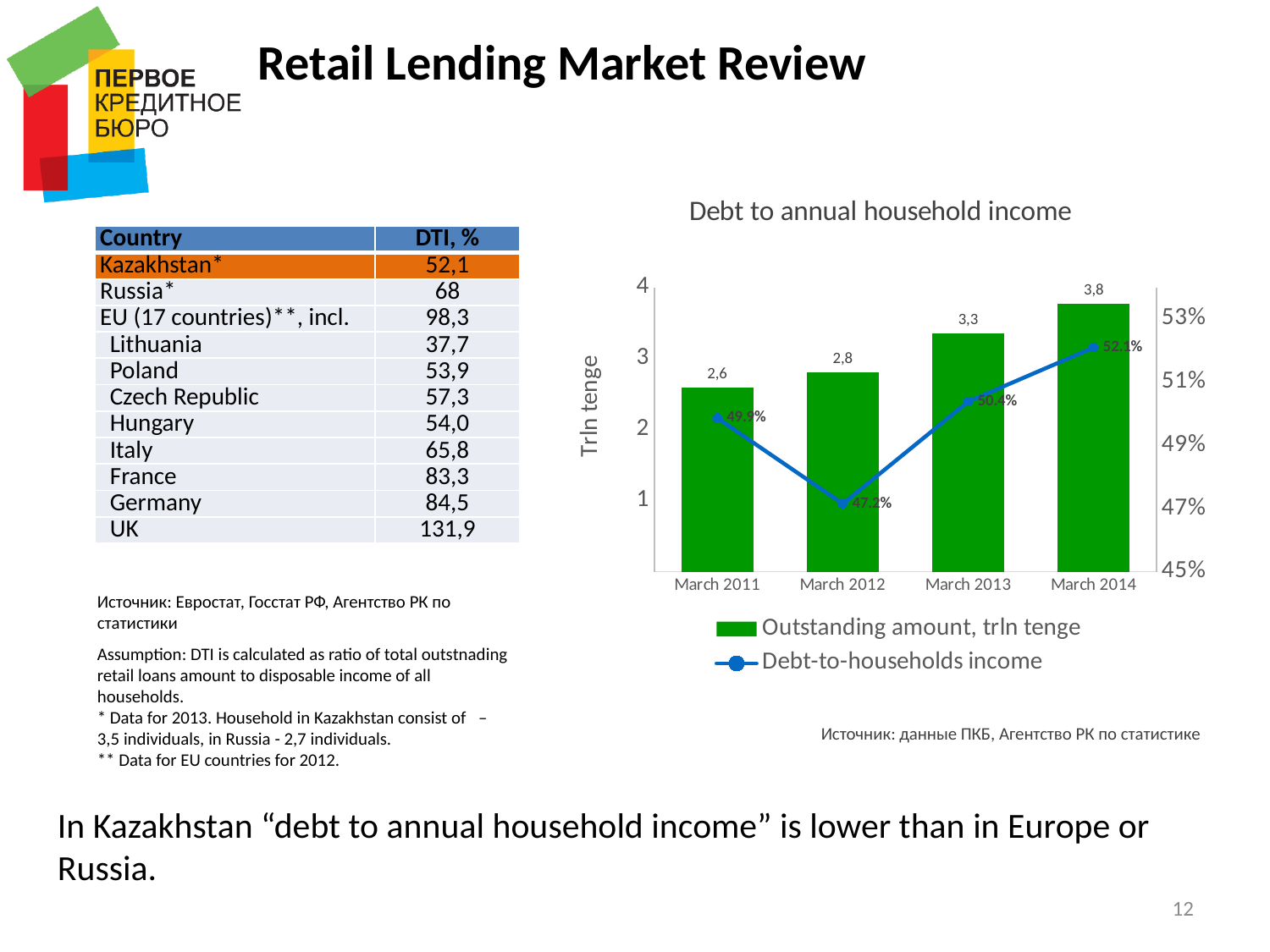
Which period has the highest outstanding amount? March 2014 Do the outstanding amount bars rise or fall from March 2011 to March 2014? rise What is the outstanding amount, in trln tenge, for March 2014? 3,8 How many periods are shown on the x axis of the chart? 4 Is the debt-to-households income value for March 2012 greater or less than 49%? less What is the outstanding amount, in trln tenge, for March 2011? 2,6 What is the title of the chart? Debt to annual household income Which period has the lowest outstanding amount? March 2011 Which is larger, the outstanding amount in March 2012 or in March 2013? March 2013 How many series does the chart legend list? 2 What is the outstanding amount, in trln tenge, for March 2013? 3,3 By how much did the outstanding amount increase from March 2011 to March 2014, in trln tenge? 1,2